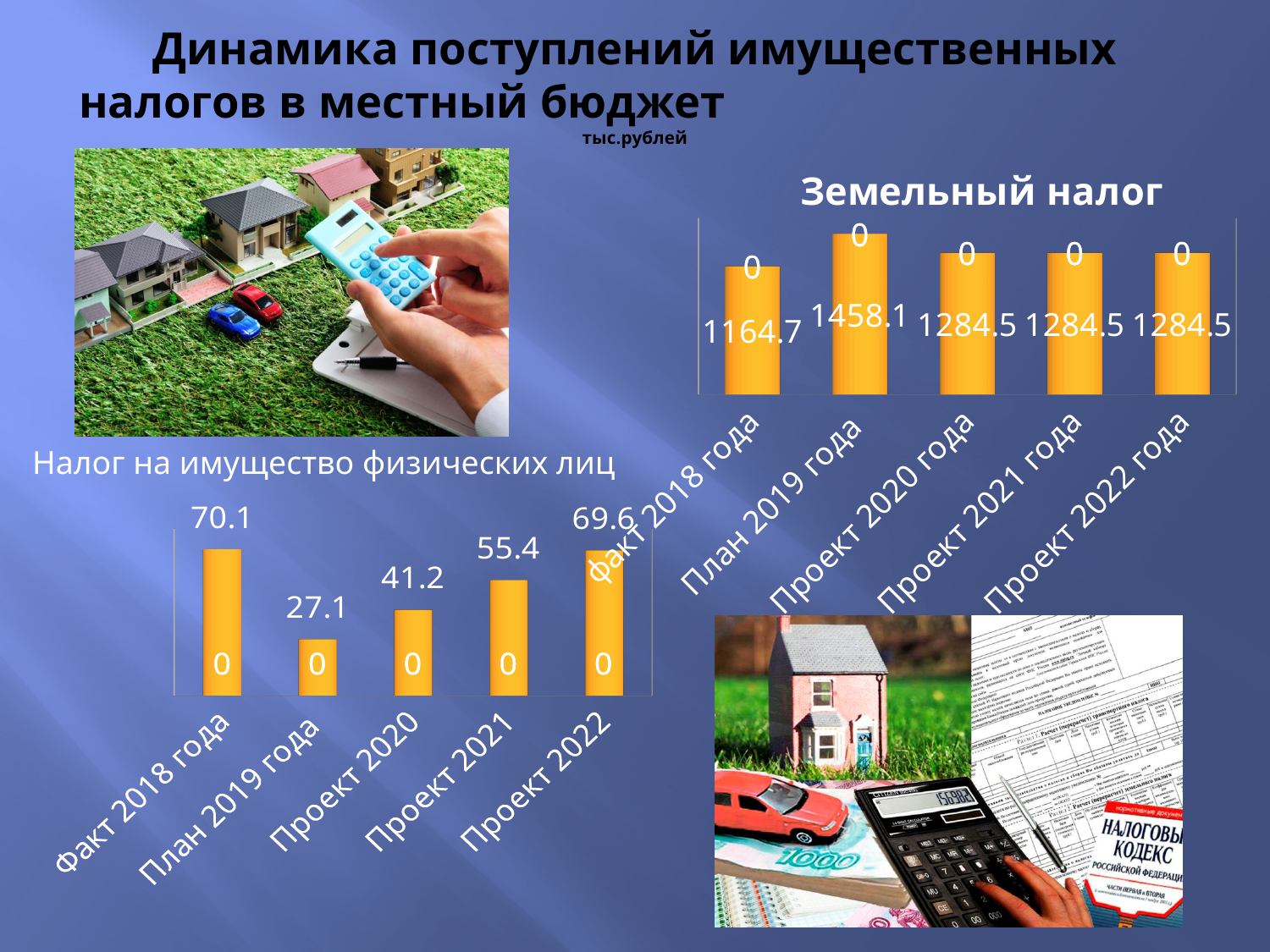
What type of chart is the 'Налог на имущество физических лиц' chart? Bar chart On the 'Земельный налог' chart, what is the difference between План 2019 года and Факт 2018 года? 293.4 On the 'Земельный налог' chart, what is the value for Факт 2018 года? 1164.7 On the 'Земельный налог' chart, what is the value for План 2019 года? 1458.1 On the 'Налог на имущество физических лиц' chart, which is larger: Проект 2020 or Проект 2022? Проект 2022 On the 'Налог на имущество физических лиц' chart, what is the value for План 2019 года? 27.1 On the 'Земельный налог' chart, which category has the lowest value? Факт 2018 года On the 'Земельный налог' chart, how many categories are shown on the x axis? 5 On the 'Налог на имущество физических лиц' chart, what is the difference between Факт 2018 года and Проект 2022? 0.5 On the 'Налог на имущество физических лиц' chart, what is the value for Проект 2021? 55.4 On the 'Налог на имущество физических лиц' chart, which category has the lowest value? План 2019 года On the 'Земельный налог' chart, which category has the highest value? План 2019 года